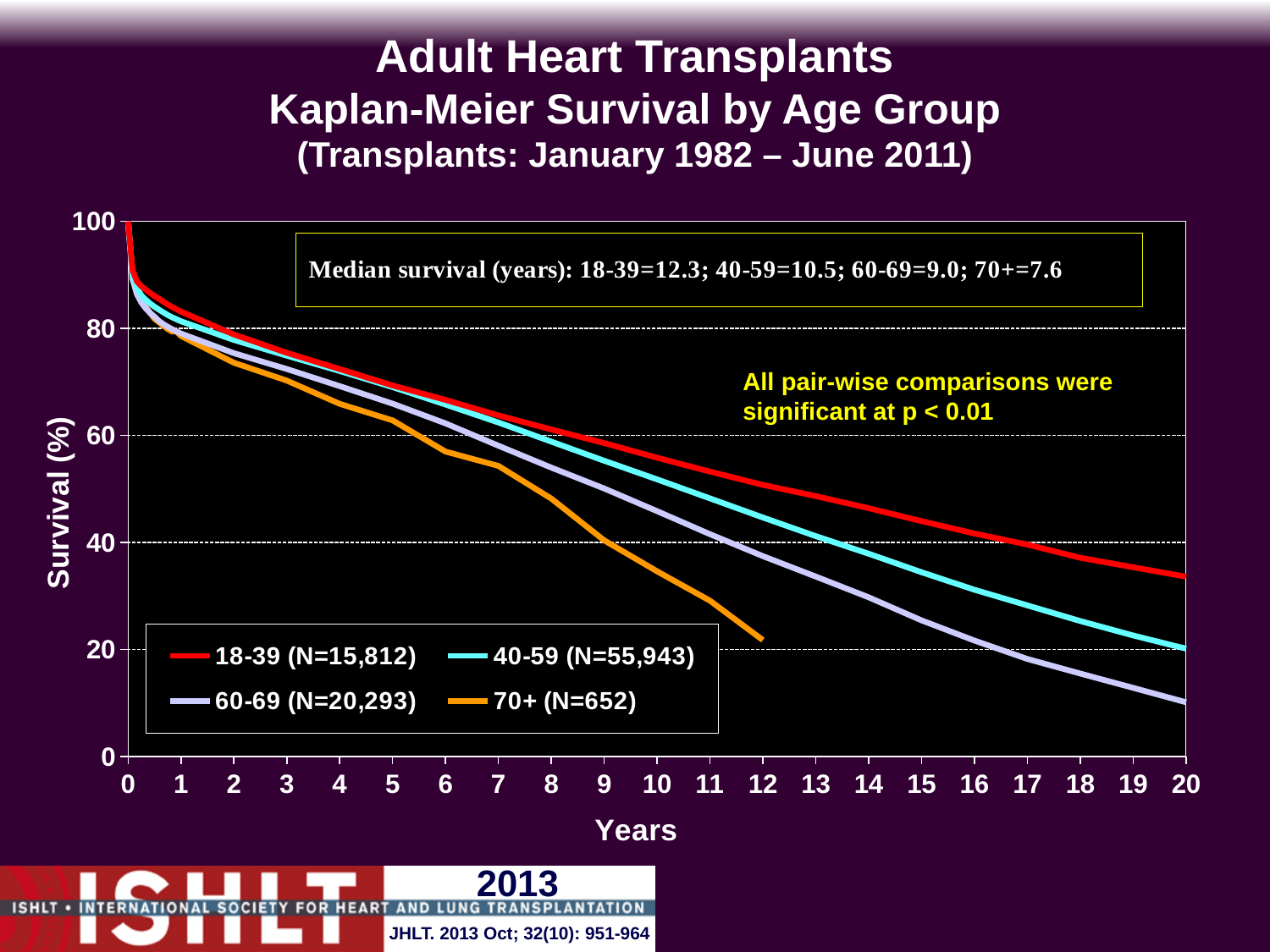
How many age-group series does the legend list? 4 What kind of chart is shown on the slide? Line chart Do the survival curves rise or fall as years increase? Fall Which age group has the highest median survival? 18-39 Which age group has the lowest median survival? 70+ What is the median survival in years for the 60-69 age group? 9.0 What is the difference in median survival (years) between the 18-39 and 40-59 age groups? 1.8 What is the median survival in years for the 70+ age group? 7.6 Is the survival value for the 70+ group at 10 years greater or less than 40? less At 15 years, which group has higher survival, 18-39 or 60-69? 18-39 What is the median survival in years for the 18-39 age group? 12.3 Is the survival value for the 18-39 group at 20 years greater or less than 20? greater